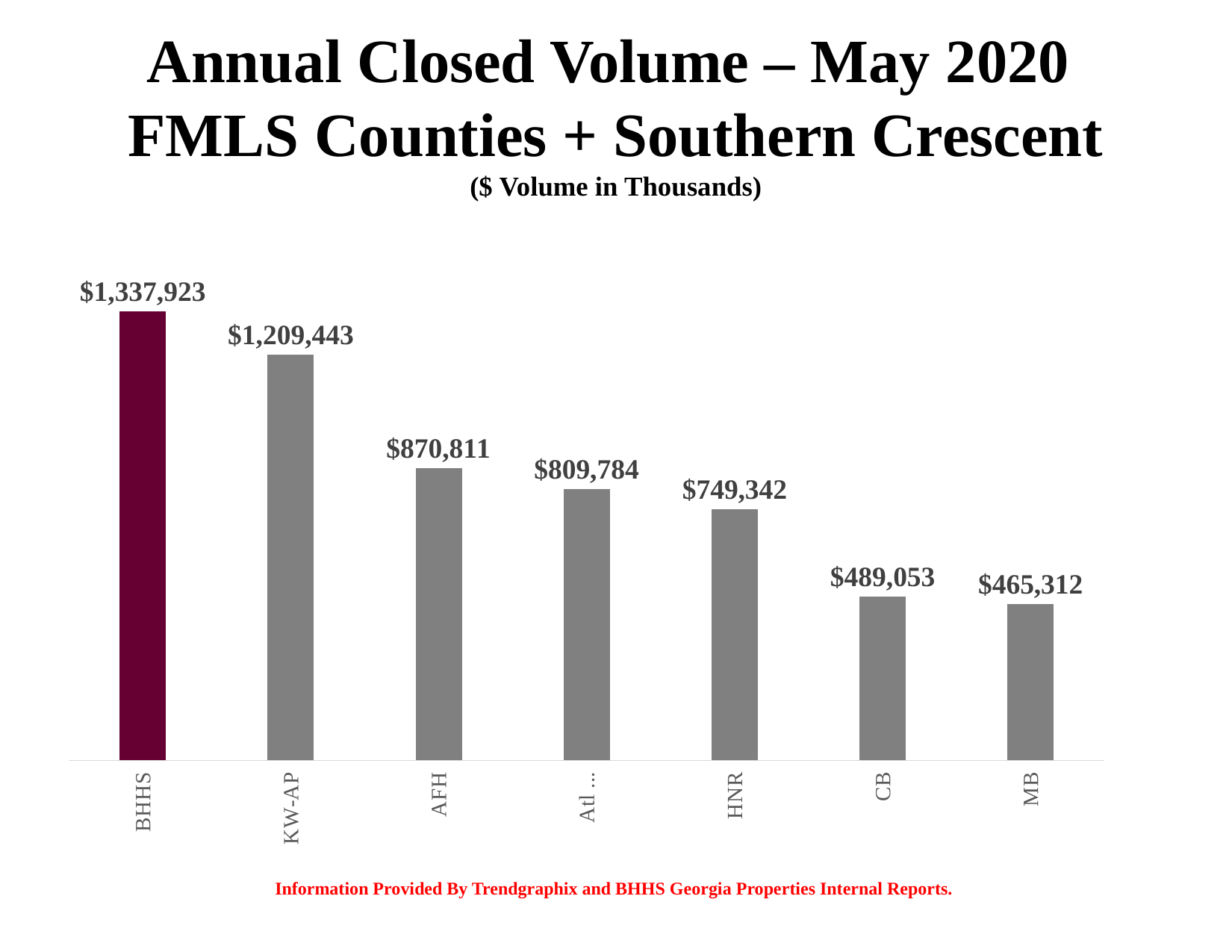
Which is larger, the value for AFH or the value for HNR? AFH Which category has the highest annual closed volume? BHHS What is the difference between the CB and MB values? $23,741 What is the annual closed volume shown for HNR? $749,342 Which category has the lowest annual closed volume? MB What is the annual closed volume shown for KW-AP? $1,209,443 What is the annual closed volume shown for MB? $465,312 Which bar is shown in a different colour (dark red) from the others? BHHS What is the difference between the BHHS and KW-AP values? $128,480 How many categories are plotted in the chart? 7 What kind of chart is shown on the slide? Bar chart What is the annual closed volume shown for BHHS? $1,337,923